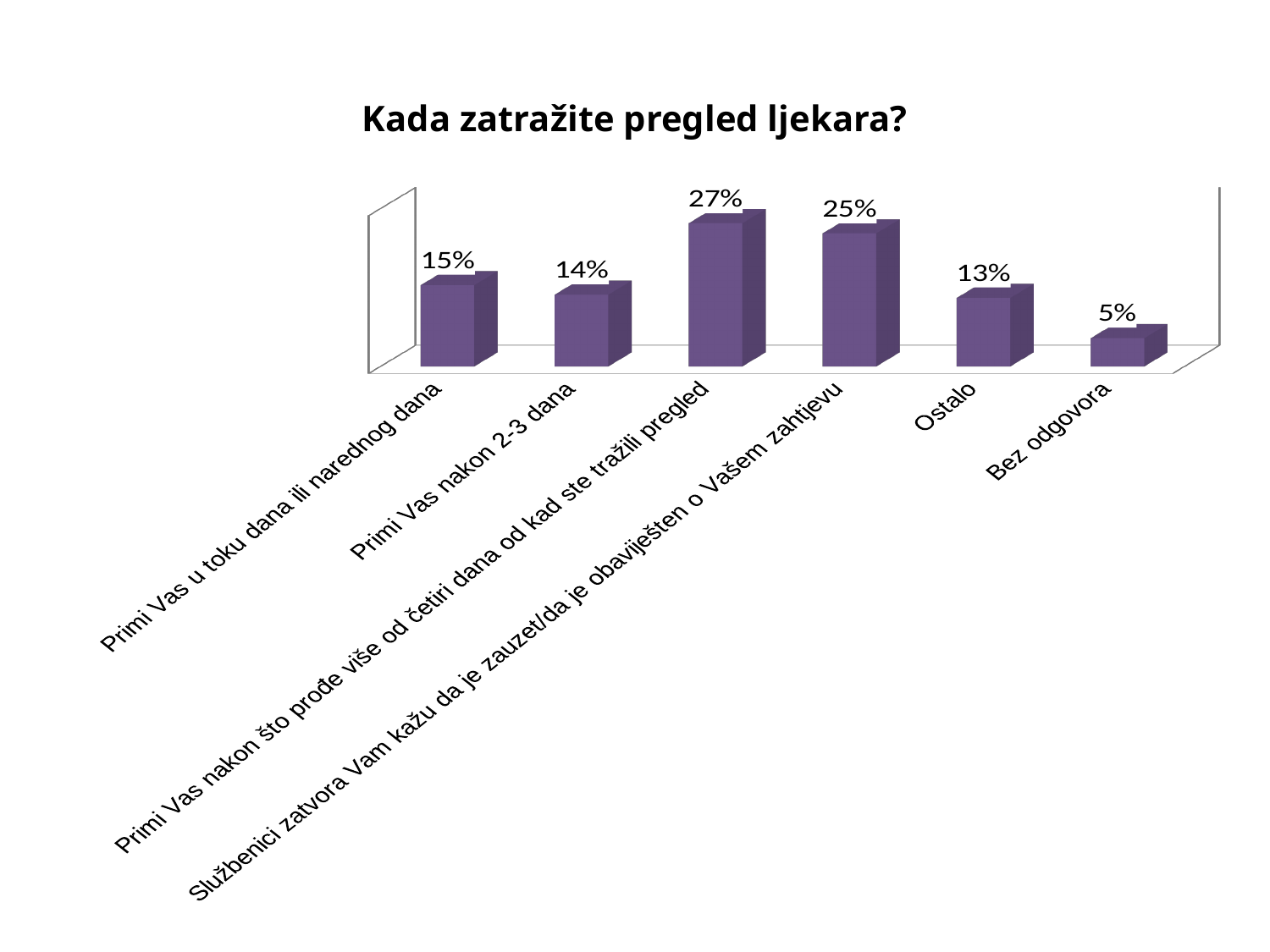
What kind of chart is shown on the slide? Bar chart What is the value for "Ostalo"? 13% What is the value for "Primi Vas nakon 2-3 dana"? 14% Which category has the highest value? Primi Vas nakon što prođe više od četiri dana od kad ste tražili pregled What is the value for "Primi Vas u toku dana ili narednog dana"? 15% Which category has the lowest value? Bez odgovora How many categories are shown in the chart? 6 What is the value for "Bez odgovora"? 5% What is the difference between the value for "Primi Vas u toku dana ili narednog dana" and the value for "Bez odgovora"? 10% What is the title of the chart? Kada zatražite pregled ljekara? Which is larger: the value for "Ostalo" or the value for "Bez odgovora"? Ostalo What is the difference between the value for "Primi Vas nakon što prođe više od četiri dana od kad ste tražili pregled" and the value for "Službenici zatvora Vam kažu da je zauzet/da je obaviješten o Vašem zahtjevu"? 2%